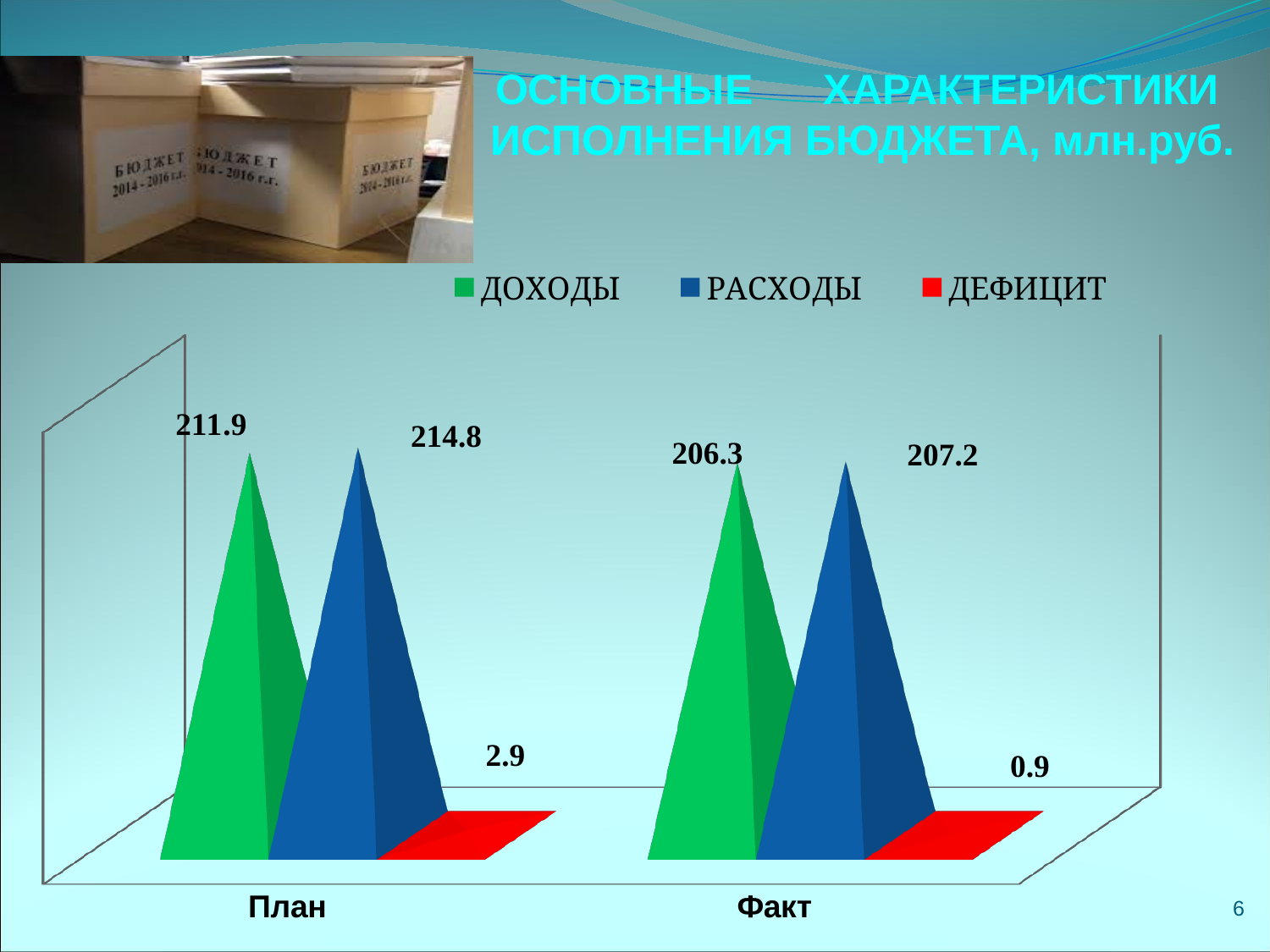
What is the value of ДЕФИЦИТ for План? 2.9 What is the value of ДОХОДЫ for Факт? 206.3 What is the value of ДЕФИЦИТ for Факт? 0.9 Which series has the lowest value for Факт? ДЕФИЦИТ What is the value of РАСХОДЫ for Факт? 207.2 What is the difference between РАСХОДЫ and ДОХОДЫ for План? 2.9 Which is larger: ДЕФИЦИТ for План or ДЕФИЦИТ for Факт? План What is the difference between ДОХОДЫ for План and ДОХОДЫ for Факт? 5.6 How many categories are shown on the x axis? 2 How many series does the legend list? 3 What is the value of ДОХОДЫ for План? 211.9 Which series has the highest value for План? РАСХОДЫ